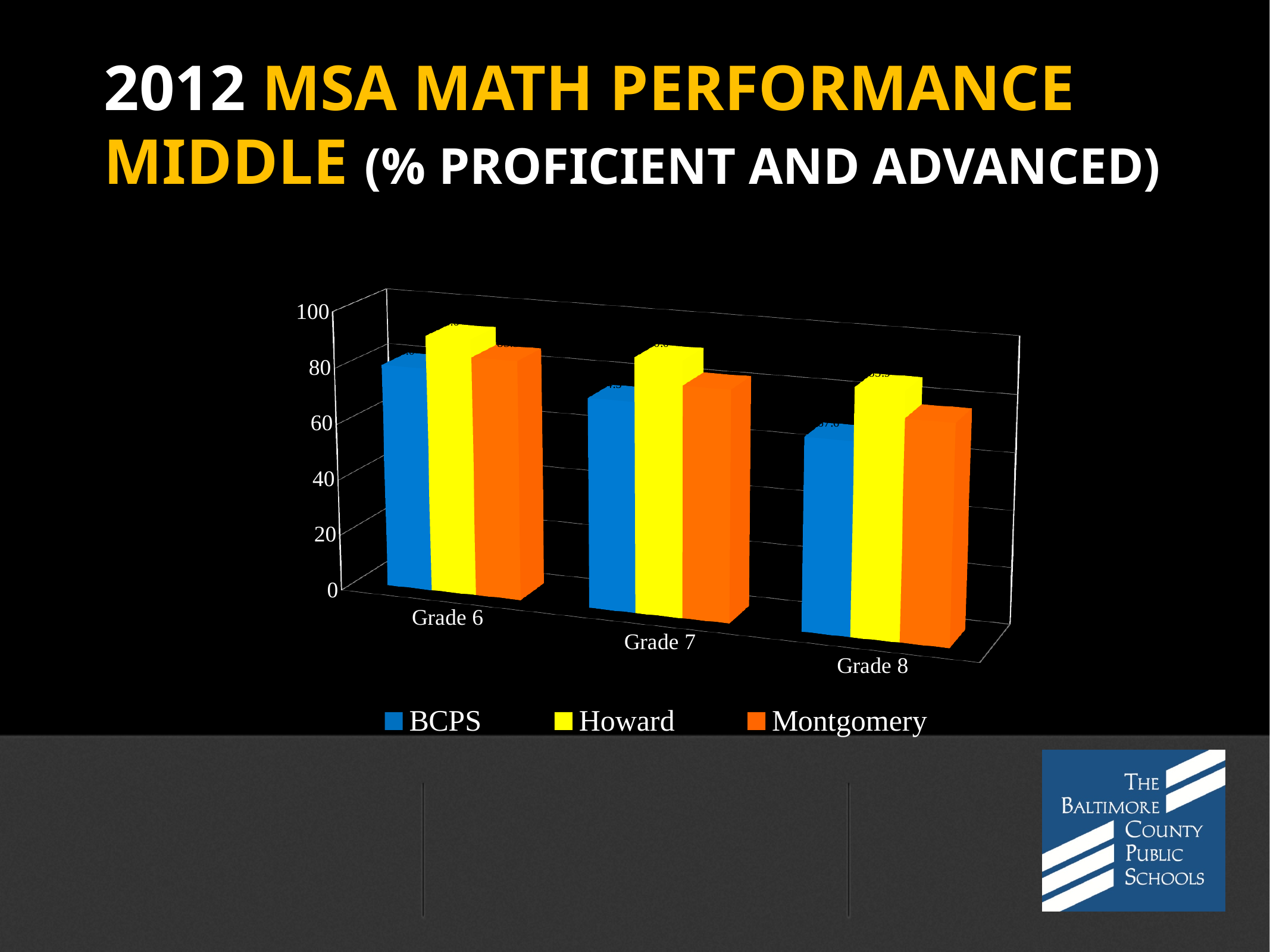
How many grade categories are shown on the x axis? 3 Is the Howard value for Grade 6 greater or less than 80? greater For Grade 8, which is larger: the BCPS value or the Montgomery value? Montgomery What kind of chart is shown on the slide? bar chart Which series has the highest value for Grade 7? Howard Which series has the highest value for Grade 6? Howard For Grade 6, which is larger: the BCPS value or the Howard value? Howard How many series does the legend list? 3 What colour represents Montgomery in the chart? orange Is the BCPS value for Grade 8 greater or less than 80? less Do the BCPS values rise or fall from Grade 6 to Grade 8? fall Which series has the lowest value for Grade 8? BCPS